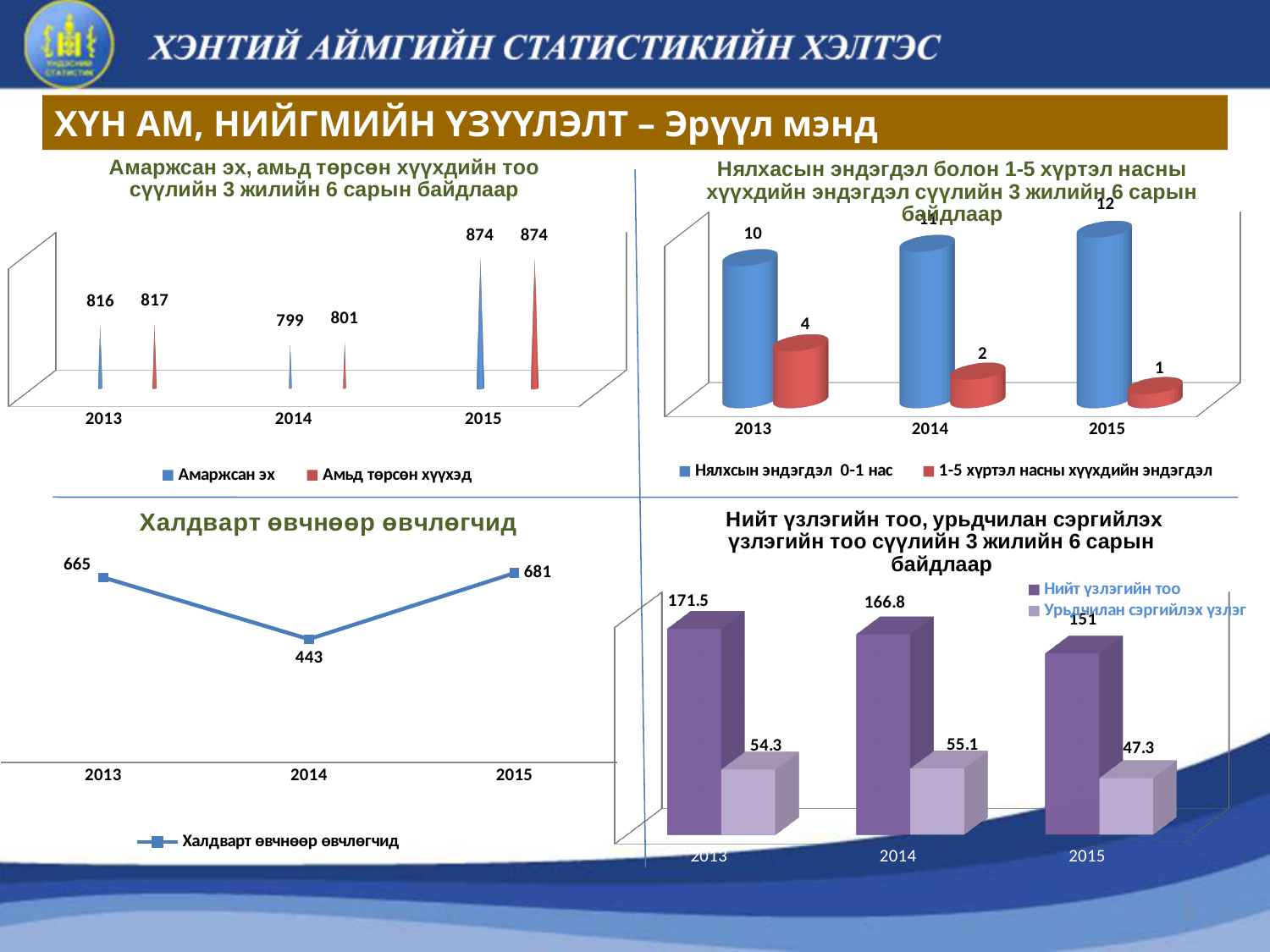
In the bottom-left chart (Халдварт өвчнөөр өвчлөгчид), what is the value for 2014? 443 In the top-right chart (Нялхасын эндэгдэл), does the value for Нялхсын эндэгдэл 0-1 нас rise or fall from 2013 to 2015? rise In the top-left chart (Амаржсан эх, амьд төрсөн хүүхдийн тоо), what is the difference between the Амаржсан эх values for 2015 and 2014? 75 In the top-right chart (Нялхасын эндэгдэл), which year has the lowest value for 1-5 хүртэл насны хүүхдийн эндэгдэл? 2015 In the top-left chart (Амаржсан эх, амьд төрсөн хүүхдийн тоо), which year has the highest value for Амаржсан эх? 2015 In the top-left chart (Амаржсан эх, амьд төрсөн хүүхдийн тоо), what is the value for Амаржсан эх in 2013? 816 In the top-left chart (Амаржсан эх, амьд төрсөн хүүхдийн тоо), what is the value for Амьд төрсөн хүүхэд in 2014? 801 In the bottom-left chart (Халдварт өвчнөөр өвчлөгчид), which is larger, the value for 2013 or 2015? 2015 What kind of chart is the bottom-left chart (Халдварт өвчнөөр өвчлөгчид)? line chart In the top-right chart (Нялхасын эндэгдэл), what is the value for Нялхсын эндэгдэл 0-1 нас in 2015? 12 In the bottom-right chart (Нийт үзлэгийн тоо), what is the difference between Нийт үзлэгийн тоо and Урьдчилан сэргийлэх үзлэг in 2015? 103.7 In the bottom-right chart (Нийт үзлэгийн тоо), what is the value for Урьдчилан сэргийлэх үзлэг in 2013? 54.3